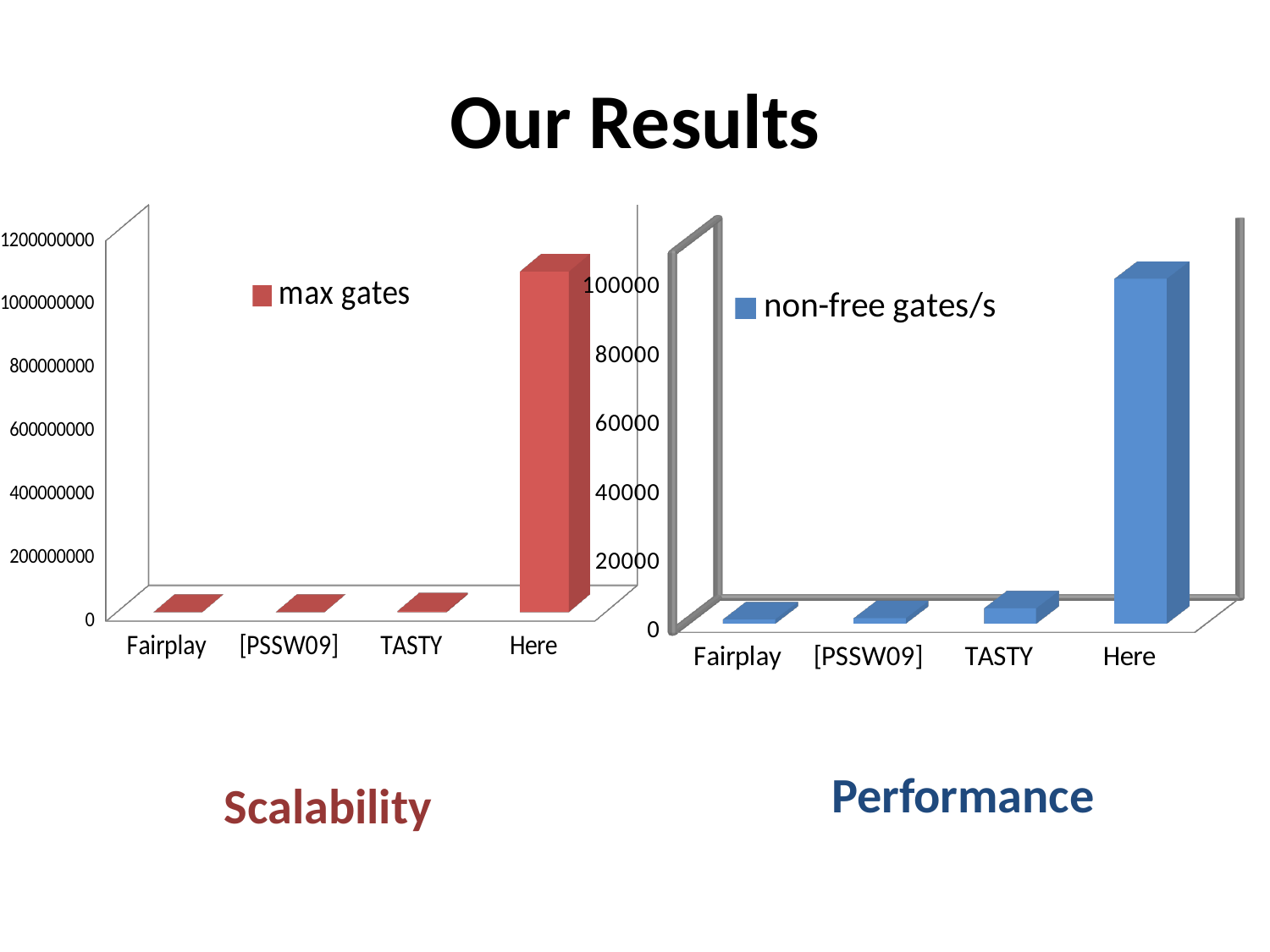
In the Performance chart on the right, is the value for Here greater or less than 80000? greater In the Performance chart on the right, which category has the highest value? Here What kind of chart is the Performance chart on the right? bar chart What kind of chart is the Scalability chart on the left? bar chart In the Scalability chart on the left, is the value for Here greater or less than 1000000000? greater What series name does the legend of the Performance chart on the right show? non-free gates/s In the Scalability chart on the left, is the value for Fairplay greater or less than 200000000? less In the Performance chart on the right, which is larger, the value for Here or the value for Fairplay? Here In the Scalability chart on the left, how many categories are shown on the x axis? 4 In the Scalability chart on the left, which category has the highest value? Here In the Performance chart on the right, how many categories are shown on the x axis? 4